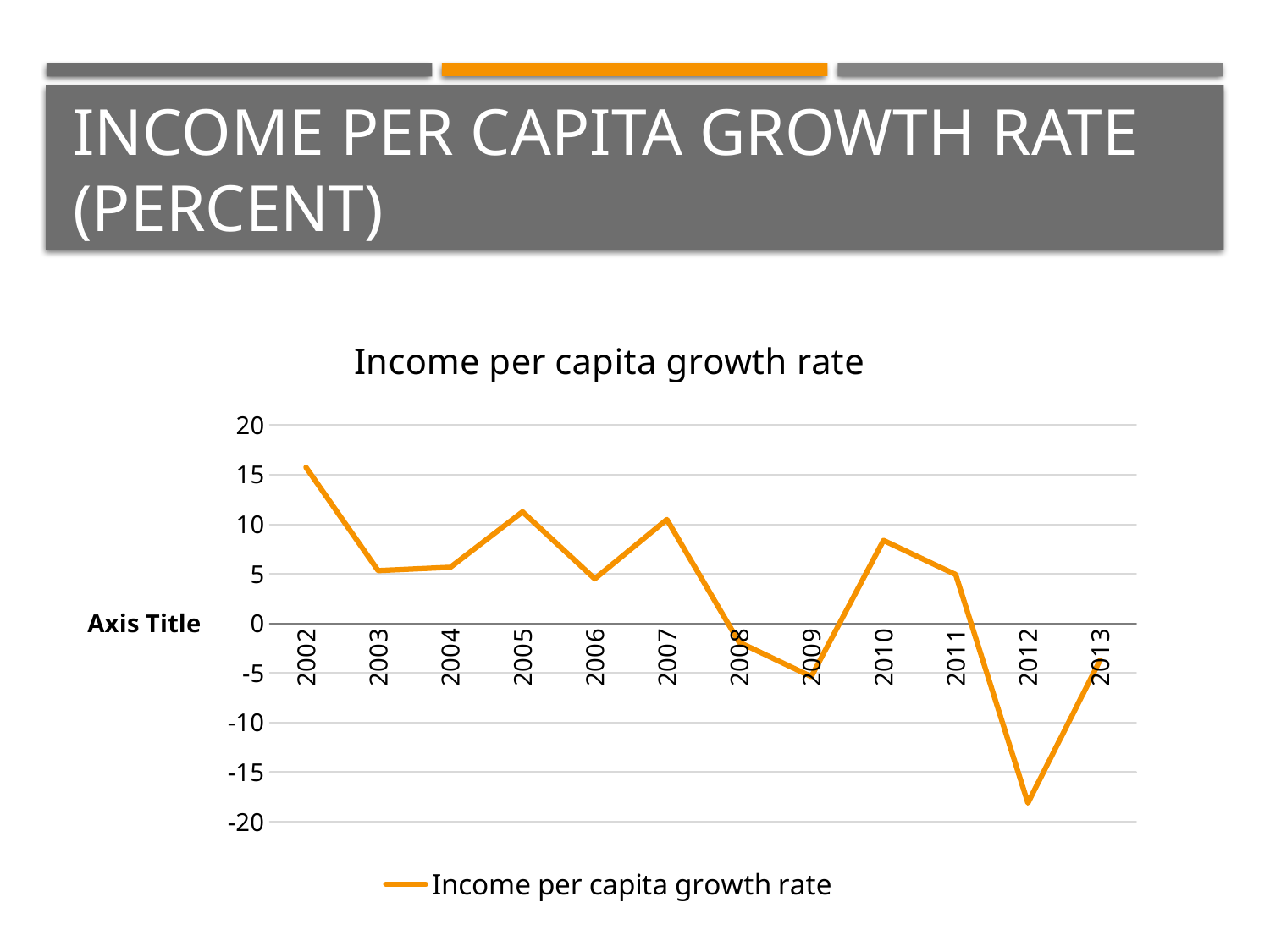
Is the value for 2005 greater or less than 10? greater What kind of chart is shown on the slide? line chart How many years are plotted along the x axis of the chart? 12 Is the value for 2008 greater or less than 0? less What is the title of the chart? Income per capita growth rate Which year has the highest income per capita growth rate? 2002 Which year has the larger value, 2010 or 2009? 2010 How many series does the legend list? 1 Does the income per capita growth rate rise or fall from 2011 to 2012? fall Is the value for 2002 greater or less than 15? greater Which year has the lowest income per capita growth rate? 2012